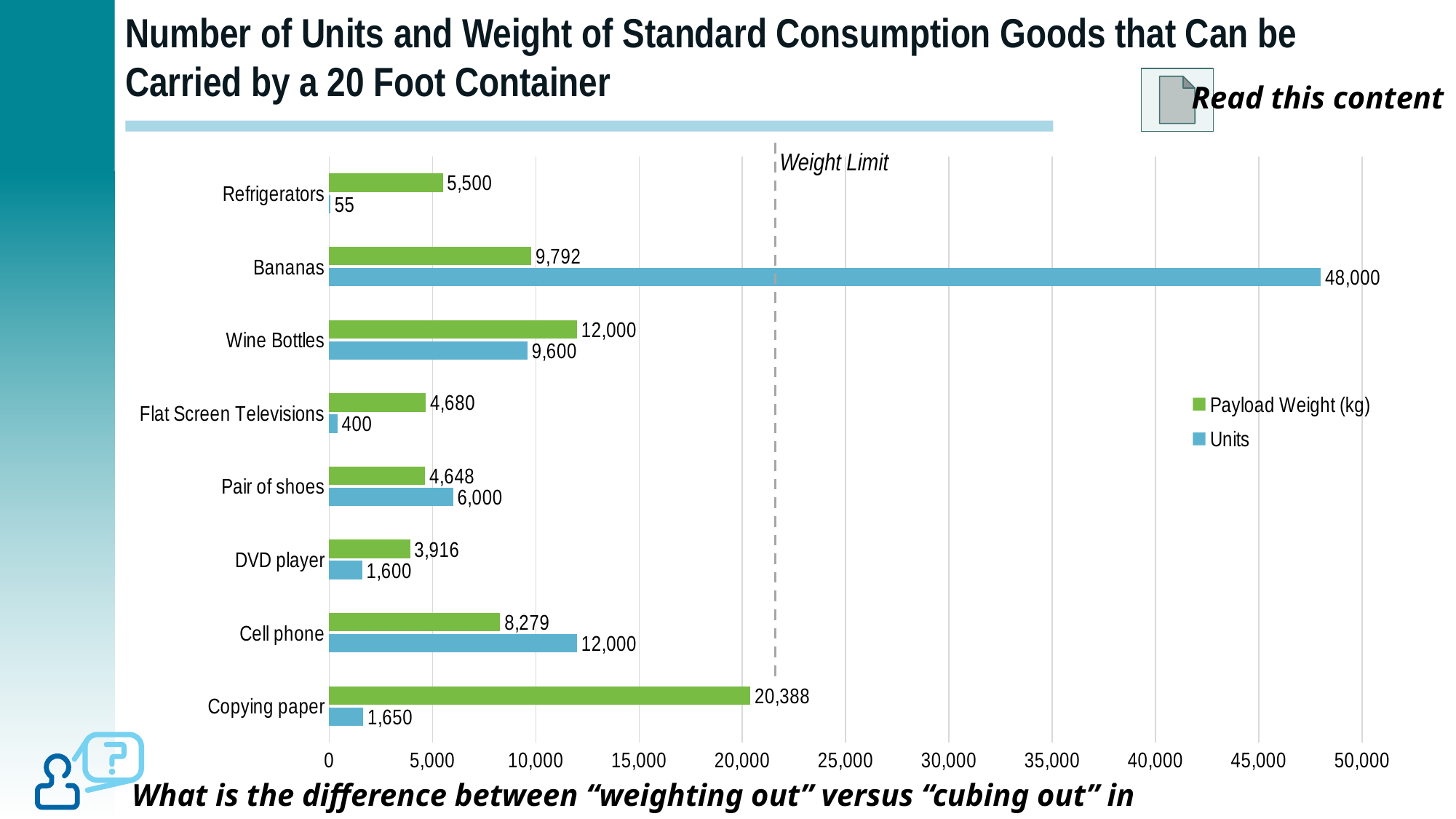
What is the Units value for Refrigerators? 55 Which is larger: the Payload Weight (kg) for Wine Bottles or the Payload Weight (kg) for Cell phone? Wine Bottles What is the Payload Weight (kg) for Copying paper? 20,388 What kind of chart is shown on the slide? Bar chart How many series does the legend list? 2 Is the Units value for Bananas greater or less than 45,000? greater Which category has the lowest Payload Weight (kg)? DVD player How many categories of goods are shown on the chart? 8 What is the difference between the Units for Bananas and the Units for Cell phone? 36,000 How many Units of Bananas can be carried? 48,000 Which category has the lowest Units value? Refrigerators Which category has the highest Payload Weight (kg)? Copying paper